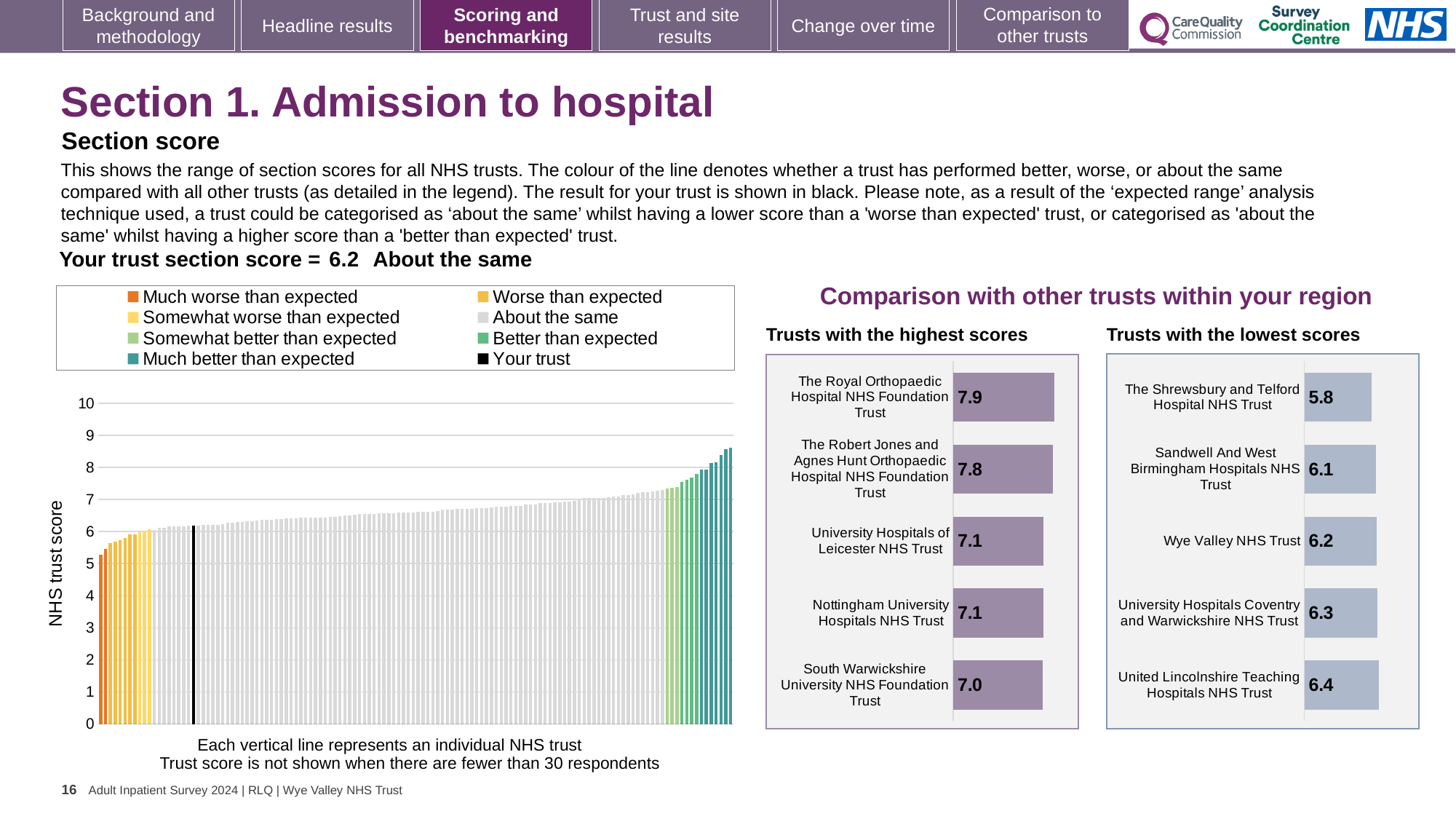
In the 'Trusts with the lowest scores' chart, what is the score for The Shrewsbury and Telford Hospital NHS Trust? 5.8 In the 'Trusts with the highest scores' chart, which trust has the lowest score? South Warwickshire University NHS Foundation Trust In the 'Trusts with the highest scores' chart, what is the score for The Royal Orthopaedic Hospital NHS Foundation Trust? 7.9 In the large chart on the left, is the value of the tallest bar greater or less than 8? greater What type of chart is the large chart on the left? bar chart In the 'Trusts with the lowest scores' chart, which has the higher score: Sandwell And West Birmingham Hospitals NHS Trust or Wye Valley NHS Trust? Wye Valley NHS Trust How many entries does the legend of the large chart on the left list? 8 In the large chart on the left, do the bar values rise or fall from left to right? rise In the 'Trusts with the lowest scores' chart, which trust has the highest score? United Lincolnshire Teaching Hospitals NHS Trust How many trusts are shown in the 'Trusts with the highest scores' chart? 5 In the 'Trusts with the lowest scores' chart, what is the difference between the scores of United Lincolnshire Teaching Hospitals NHS Trust and The Shrewsbury and Telford Hospital NHS Trust? 0.6 In the 'Trusts with the highest scores' chart, what is the difference between the scores of The Royal Orthopaedic Hospital NHS Foundation Trust and South Warwickshire University NHS Foundation Trust? 0.9